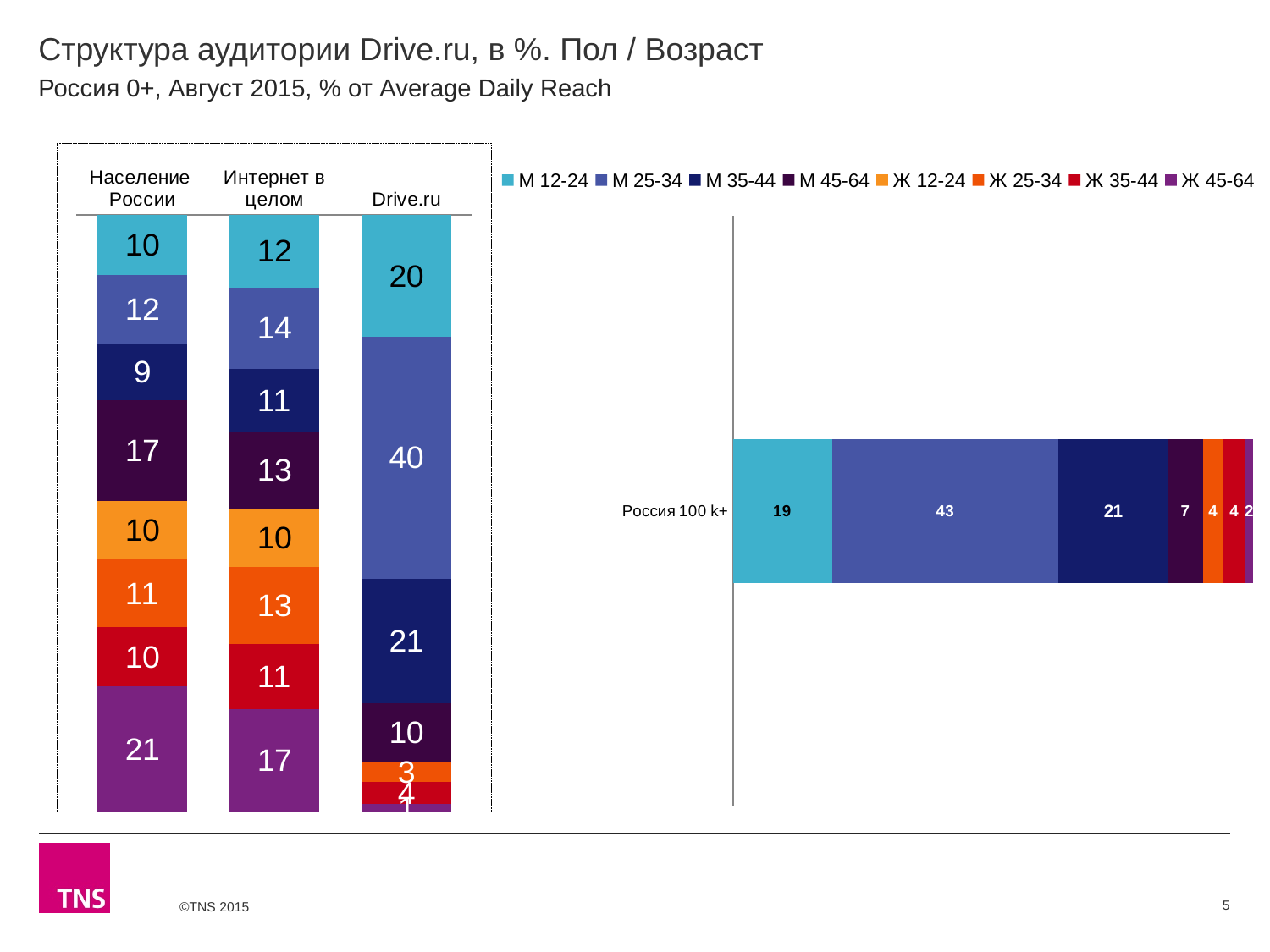
How many bars are shown in the left chart? 3 In the left chart, which series has the largest segment in the Drive.ru bar? М 25-34 In the right chart (Россия 100 k+), what is the difference between the М 25-34 and М 12-24 values? 24 In the right chart (Россия 100 k+), what is the value for М 25-34? 43 In the right chart (Россия 100 k+), what is the value for М 35-44? 21 In the left chart, what is the value for М 25-34 in the Drive.ru bar? 40 In the left chart, what is the value for М 25-34 in the Интернет в целом bar? 14 In the left chart, how much larger is the М 25-34 value for Drive.ru than for Население России? 30 In the right chart (Россия 100 k+), which series has the largest segment? М 25-34 How many series does the legend list? 8 In the left chart, which bar has the larger М 45-64 value: Население России or Интернет в целом? Население России In the left chart, what is the value for Ж 45-64 in the Население России bar? 21